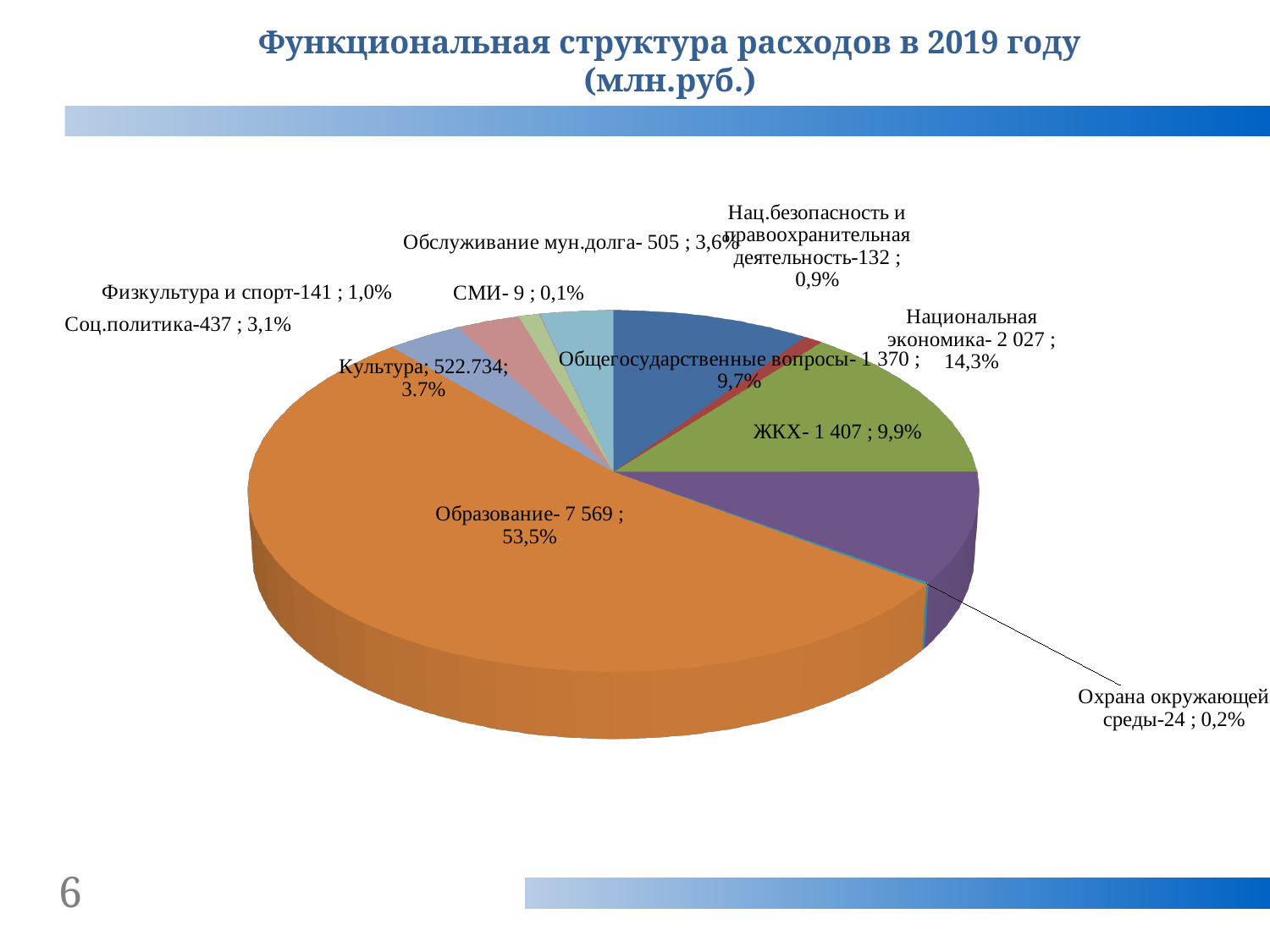
What is the difference between the values for Национальная экономика and ЖКХ? 620 What share of the pie does ЖКХ take? 9,9% What is the value for Образование? 7 569 What is the title of the chart? Функциональная структура расходов в 2019 году (млн.руб.) Which category has the largest slice of the pie? Образование How many categories are shown in the pie chart? 11 What is the value for Охрана окружающей среды? 24 What share of the pie does Образование take? 53,5% What kind of chart is shown on the slide? pie chart Which is larger, the value for Общегосударственные вопросы or the value for ЖКХ? ЖКХ What is the value for Национальная экономика? 2 027 Which category has the smallest slice of the pie? СМИ